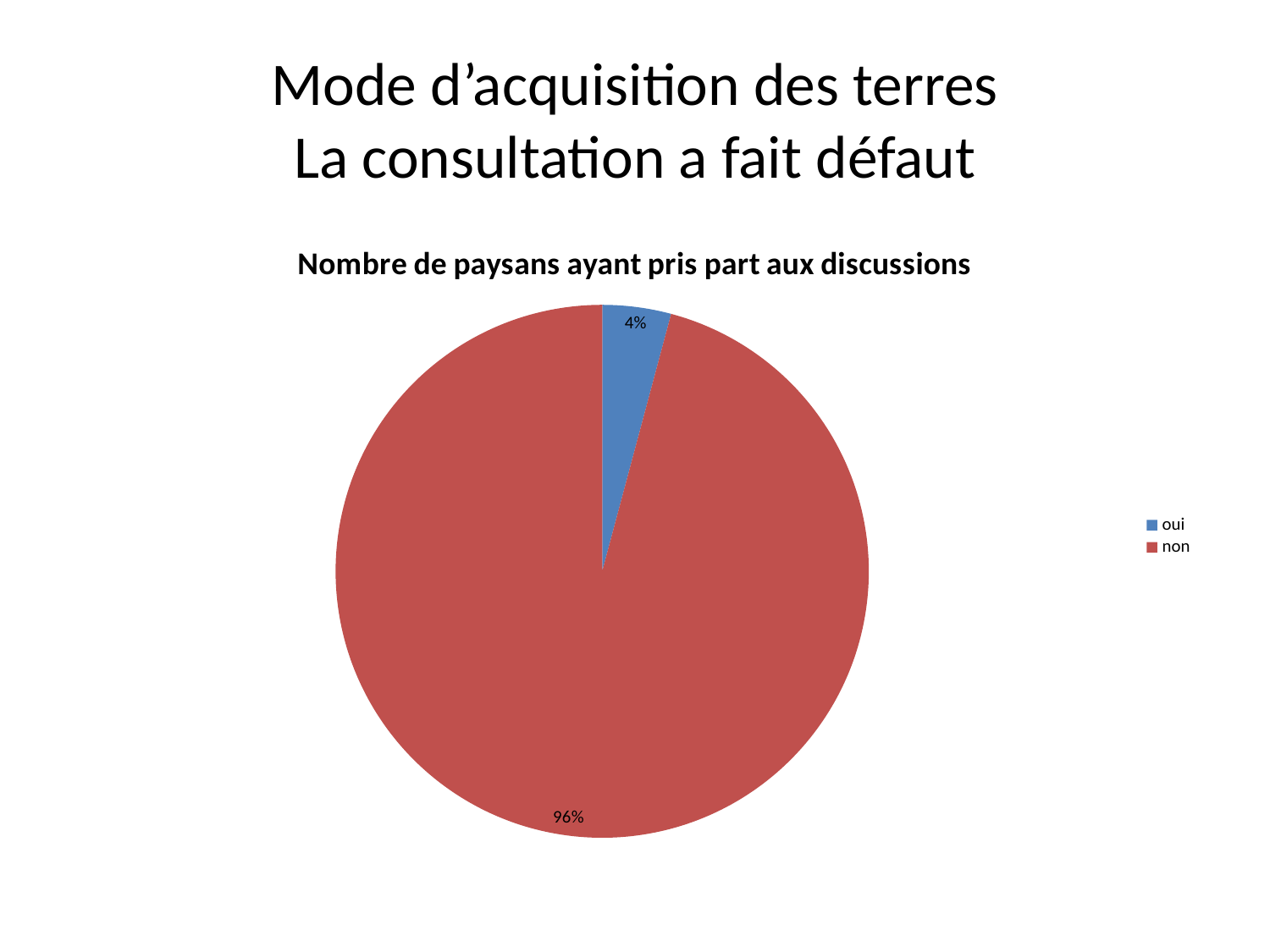
Which category has the largest slice of the pie? non What is the title of the chart? Nombre de paysans ayant pris part aux discussions How many categories does the pie chart show? 2 How many entries does the legend list? 2 What is the difference in percentage points between the "non" share and the "oui" share? 92 What colour is the "non" slice in the pie chart? red What share of the pie does the "non" slice represent? 96% What kind of chart is shown on the slide? pie chart What share of the pie does the "oui" slice represent? 4% Which is larger, the share for "oui" or the share for "non"? non Which category has the smallest slice of the pie? oui